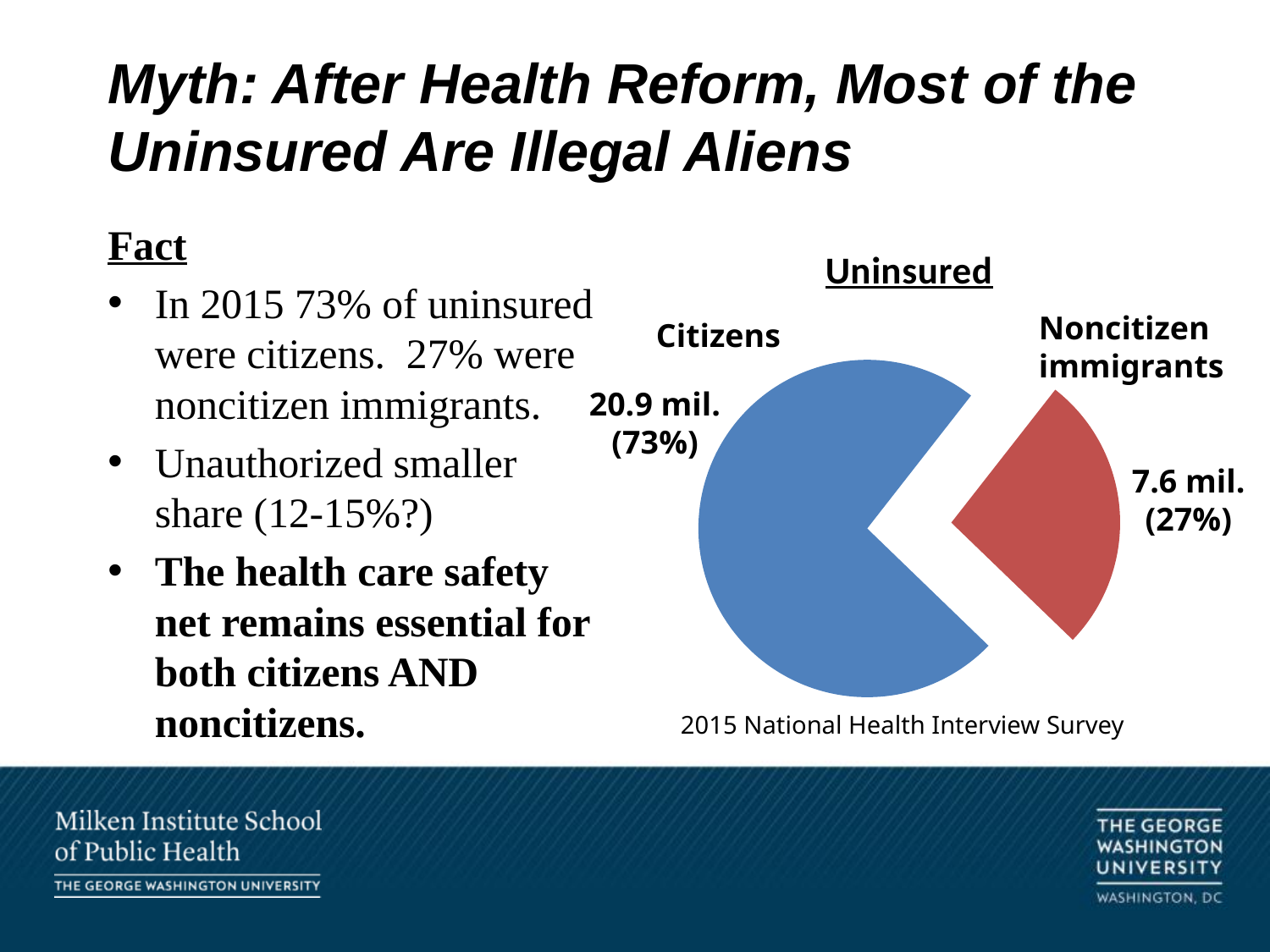
What share of the pie do Citizens represent? 73% What value is shown for the Citizens slice? 20.9 mil. What share of the pie do Noncitizen immigrants represent? 27% How many slices does the pie chart have? 2 What kind of chart is shown on the slide? Pie chart What is the title of the chart? Uninsured What value is shown for the Noncitizen immigrants slice? 7.6 mil. Which is larger, the Citizens slice or the Noncitizen immigrants slice? Citizens What is the difference in millions between the Citizens and Noncitizen immigrants values? 13.3 mil. What colour is the Noncitizen immigrants slice? Red Which slice is the largest? Citizens Which slice is the smallest? Noncitizen immigrants